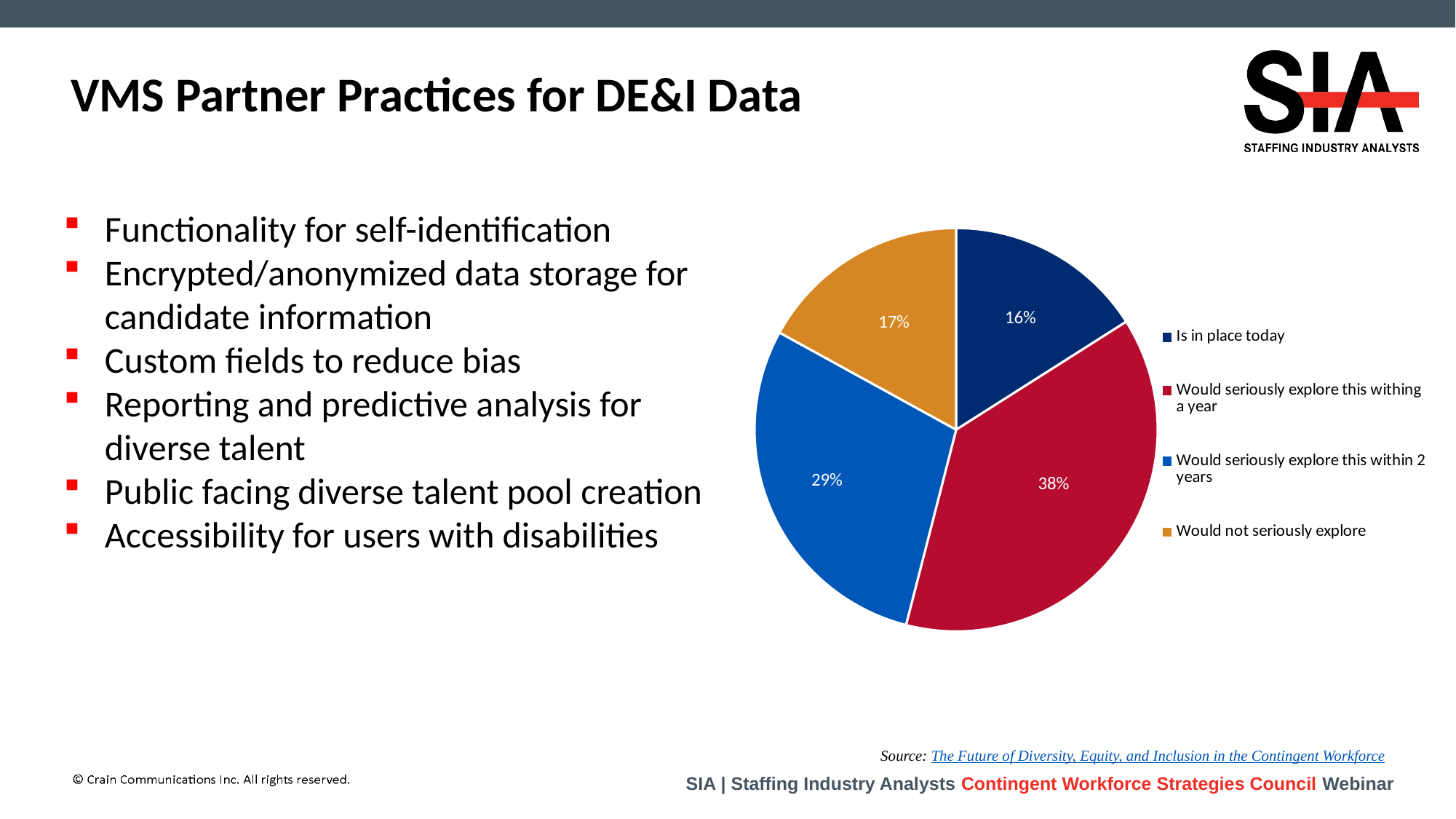
What is the combined share of the two "Would seriously explore" categories? 67% What percentage of the pie is labelled "Would seriously explore this withing a year"? 38% What is the difference in percentage points between "Would seriously explore this withing a year" and "Would seriously explore this within 2 years"? 9 Which category has the smallest slice of the pie? Is in place today What kind of chart is shown on the slide? pie chart How many slices does the pie chart have? 4 What colour is the slice for "Would not seriously explore"? orange Which is larger: "Would not seriously explore" or "Is in place today"? Would not seriously explore Which category has the largest slice of the pie? Would seriously explore this withing a year What percentage of the pie is labelled "Would seriously explore this within 2 years"? 29% What percentage of the pie is labelled "Would not seriously explore"? 17% What percentage of the pie is labelled "Is in place today"? 16%